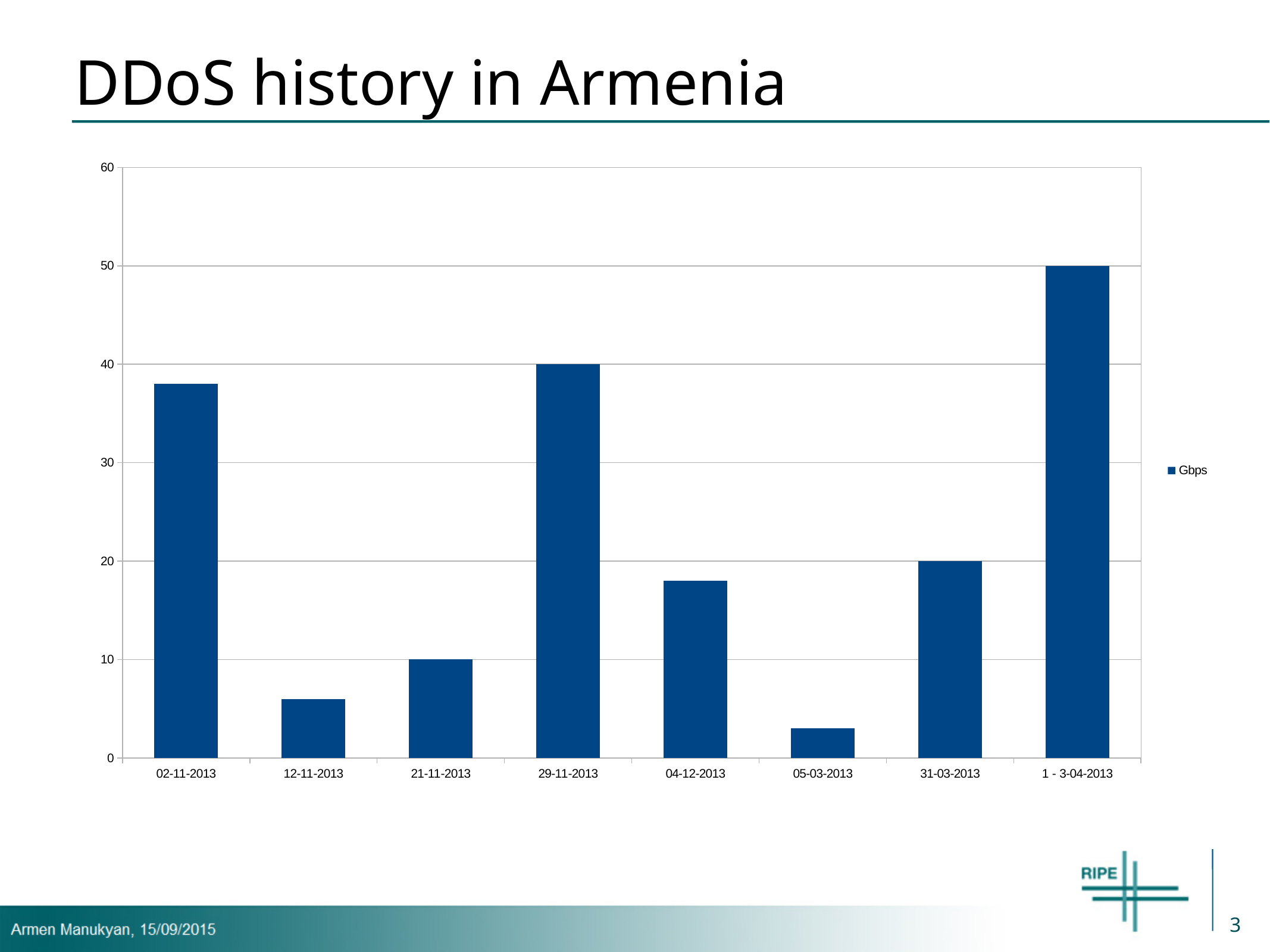
Which is larger, the value for 12-11-2013 or the value for 21-11-2013? 21-11-2013 What is the value for 31-03-2013? 20 Is the value for 02-11-2013 greater or less than 30? greater Which date has the highest value in the chart? 1 - 3-04-2013 What is the name of the series shown in the legend? Gbps How many dates (bars) are shown on the x axis of the chart? 8 What is the value for 29-11-2013? 40 Which date has the lowest value in the chart? 05-03-2013 What type of chart is shown on the slide? bar chart What is the value for 1 - 3-04-2013? 50 How many series does the chart's legend list? 1 What is the difference between the values for 1 - 3-04-2013 and 29-11-2013? 10